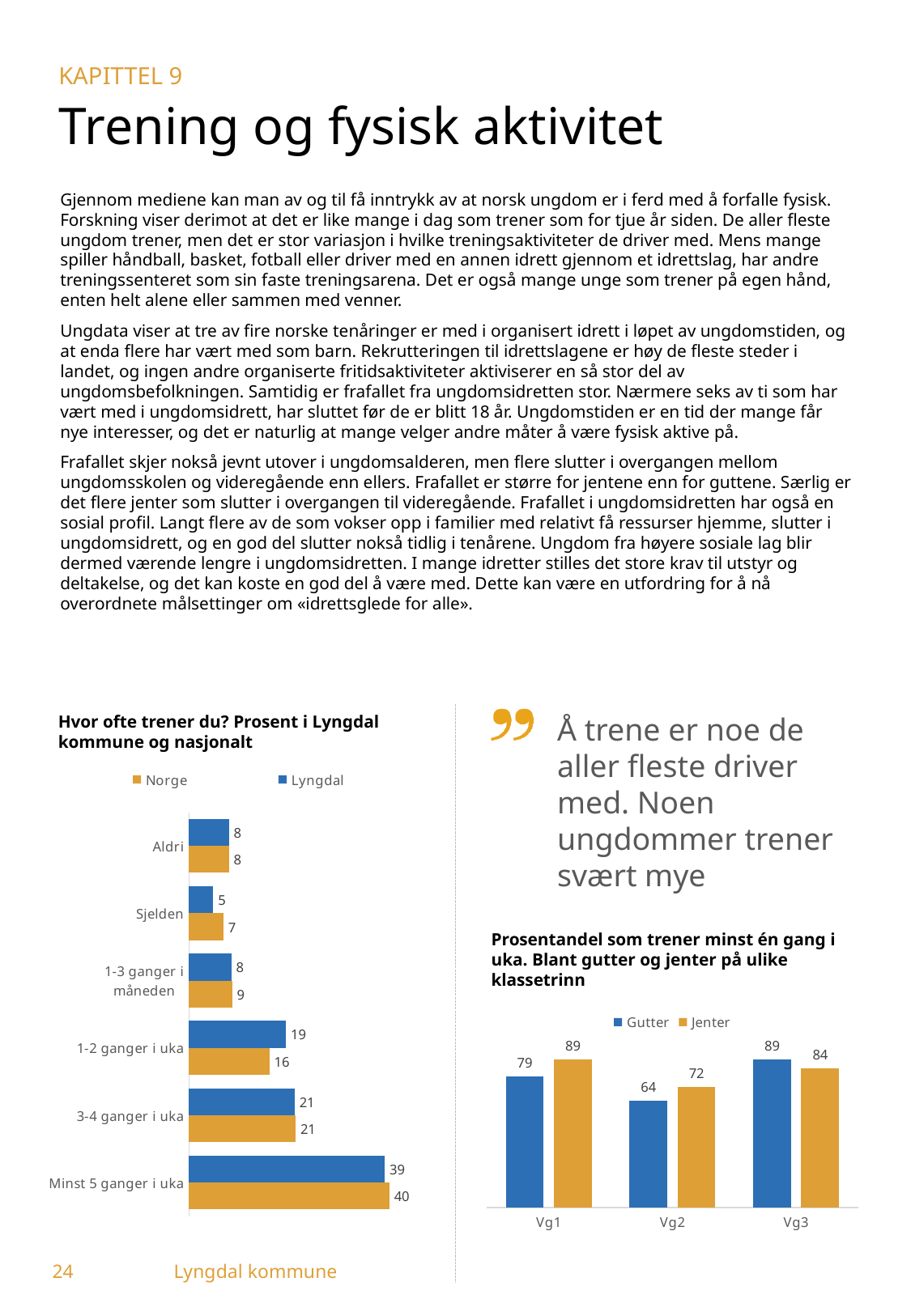
In the chart 'Hvor ofte trener du? Prosent i Lyngdal kommune og nasjonalt', how many series does the legend list? 2 In the chart 'Prosentandel som trener minst én gang i uka', which colour represents Jenter? Orange In the chart 'Prosentandel som trener minst én gang i uka', which is larger at Vg3, Gutter or Jenter? Gutter In the chart 'Hvor ofte trener du? Prosent i Lyngdal kommune og nasjonalt', what is the value for Norge for 'Sjelden'? 7 In the chart 'Hvor ofte trener du? Prosent i Lyngdal kommune og nasjonalt', which category has the lowest value for Lyngdal? Sjelden In the chart 'Hvor ofte trener du? Prosent i Lyngdal kommune og nasjonalt', which category has the highest value for Lyngdal? Minst 5 ganger i uka In the chart 'Prosentandel som trener minst én gang i uka', what is the value for Jenter at Vg2? 72 In the chart 'Hvor ofte trener du? Prosent i Lyngdal kommune og nasjonalt', how many categories are shown? 6 In the chart 'Hvor ofte trener du? Prosent i Lyngdal kommune og nasjonalt', what is the value for Lyngdal for 'Minst 5 ganger i uka'? 39 In the chart 'Hvor ofte trener du? Prosent i Lyngdal kommune og nasjonalt', what is the difference between Lyngdal and Norge for '1-2 ganger i uka'? 3 In the chart 'Prosentandel som trener minst én gang i uka', what is the difference between Jenter and Gutter at Vg1? 10 What kind of chart is 'Hvor ofte trener du? Prosent i Lyngdal kommune og nasjonalt'? Bar chart